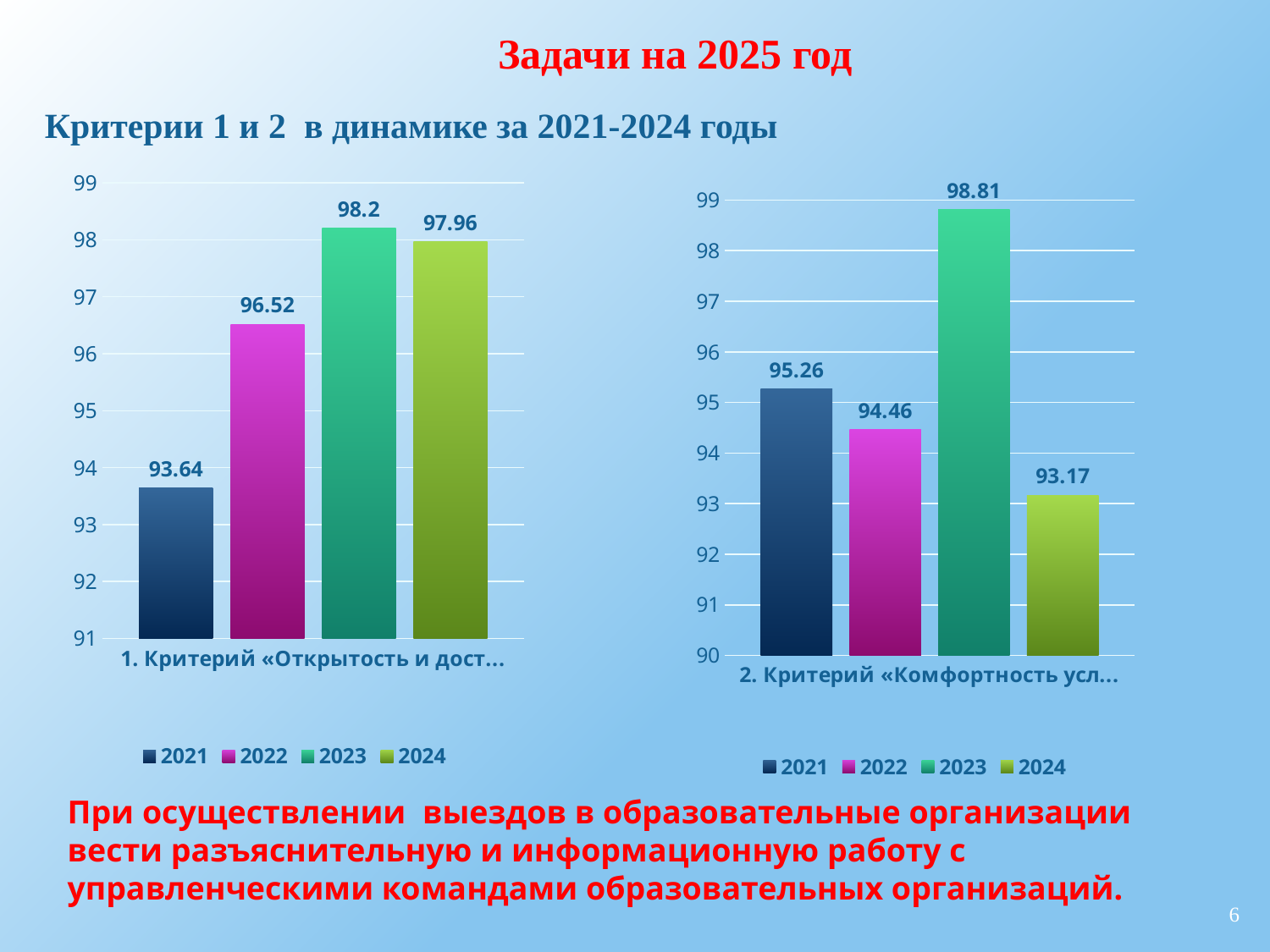
In the right chart (Критерий 2), what is the difference between the 2023 and 2024 values? 5.64 In the left chart (Критерий 1), do the values rise or fall from 2021 to 2023? rise In the right chart (Критерий 2), which year has the lowest value? 2024 In the left chart (Критерий 1), what is the value for 2022? 96.52 How many series does the legend of the left chart list? 4 In the left chart (Критерий 1), is the value for 2024 greater or less than 97? greater In the right chart (Критерий 2), what is the value for 2023? 98.81 In the left chart (Критерий 1), what is the difference between the 2022 and 2021 values? 2.88 In the left chart (Критерий 1), what is the value for 2021? 93.64 What kind of chart is the right chart (Критерий 2)? bar chart In the left chart (Критерий 1), which year has the highest value? 2023 In the right chart (Критерий 2), which is larger, the value for 2021 or the value for 2022? 2021